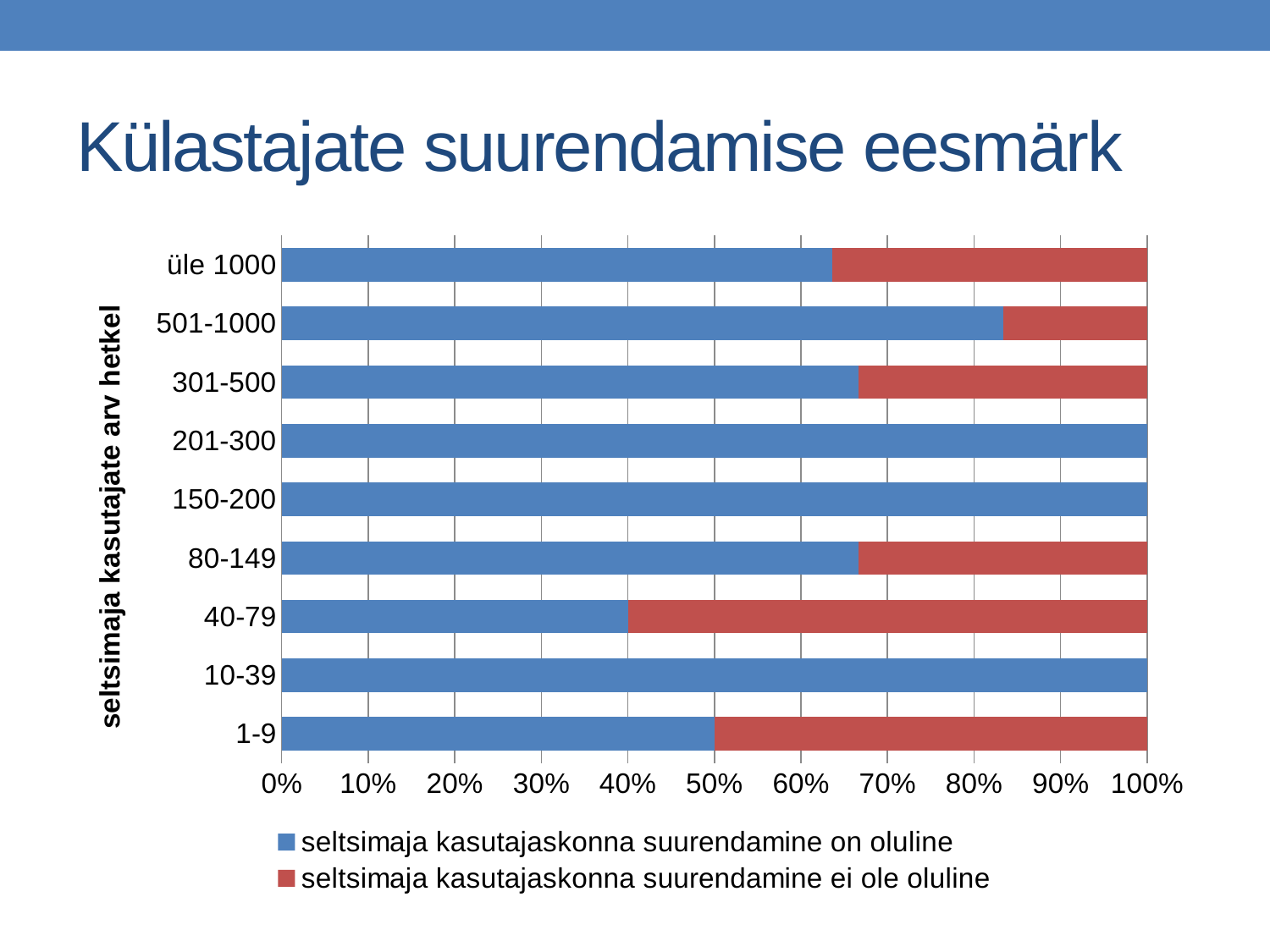
Which category has the lowest share of 'seltsimaja kasutajaskonna suurendamine on oluline'? 40-79 Is the 'on oluline' share for the üle 1000 category greater or less than 60%? greater Is the 'on oluline' share for the 501-1000 category greater or less than 80%? greater How many categories are shown on the vertical axis of the chart? 9 What is the title of the slide containing the chart? Külastajate suurendamise eesmärk What share of the 40-79 category says 'seltsimaja kasutajaskonna suurendamine on oluline'? 40% How many series does the legend list? 2 What is the label of the vertical axis? seltsimaja kasutajate arv hetkel What share of the 1-9 category says 'seltsimaja kasutajaskonna suurendamine on oluline'? 50% Which has a larger 'on oluline' share: 501-1000 or 301-500? 501-1000 What share of the 201-300 category says 'seltsimaja kasutajaskonna suurendamine on oluline'? 100% What kind of chart is shown on the slide? Stacked bar chart